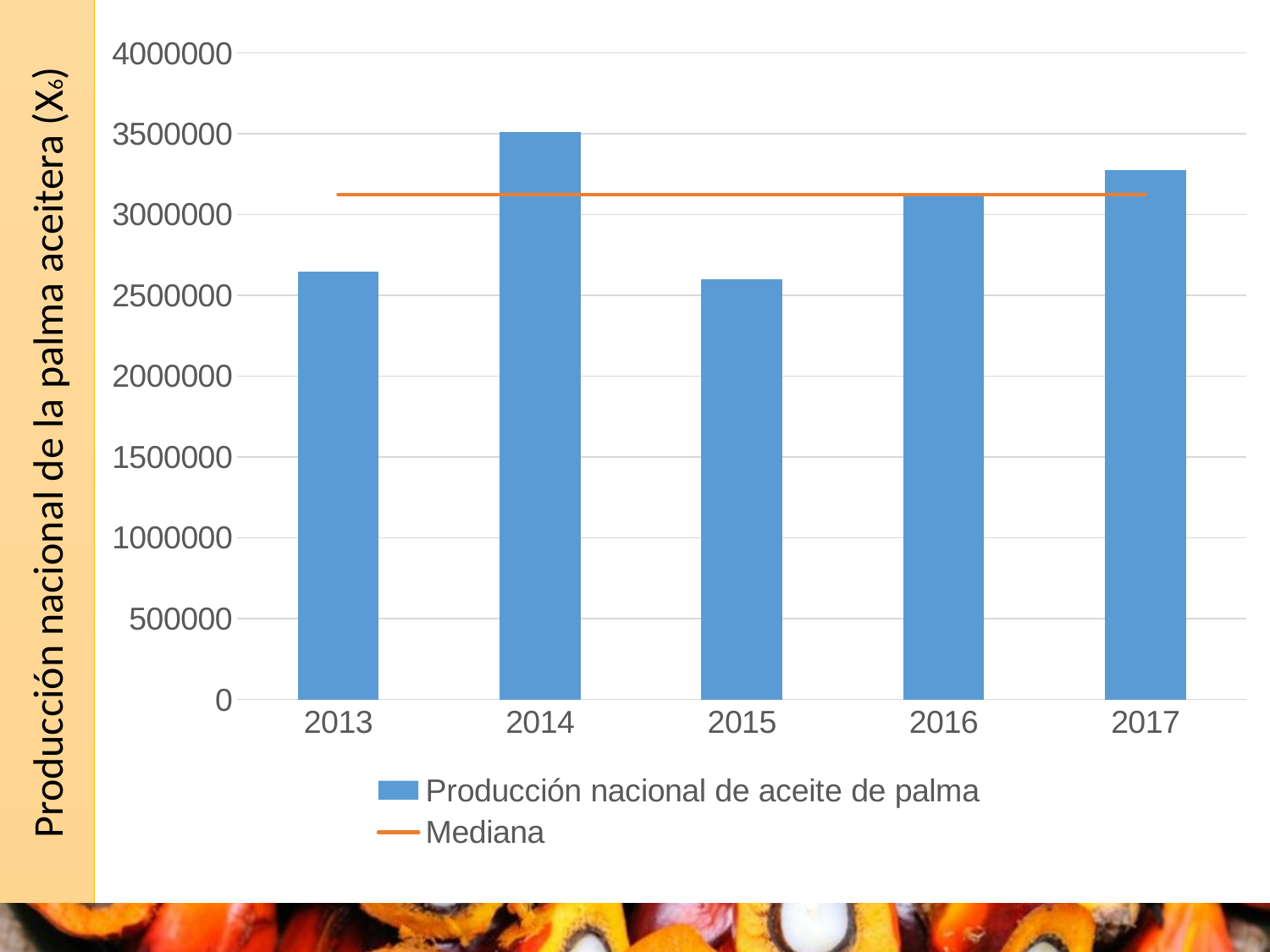
Is the value for 2017 greater or less than 3500000? less Is the value for 2016 greater or less than 3000000? greater How many years are shown on the x axis of the chart? 5 Which year has the highest Producción nacional de aceite de palma? 2014 Which year has the larger value, 2014 or 2017? 2014 Is the value for 2015 greater or less than 2500000? greater What is the title of the vertical axis? Producción nacional de la palma aceitera (X6) Does the value rise or fall from 2014 to 2015? fall What kind of chart is shown on the slide? combination bar and line chart What is the name of the line series shown in the legend? Mediana How many series does the legend list? 2